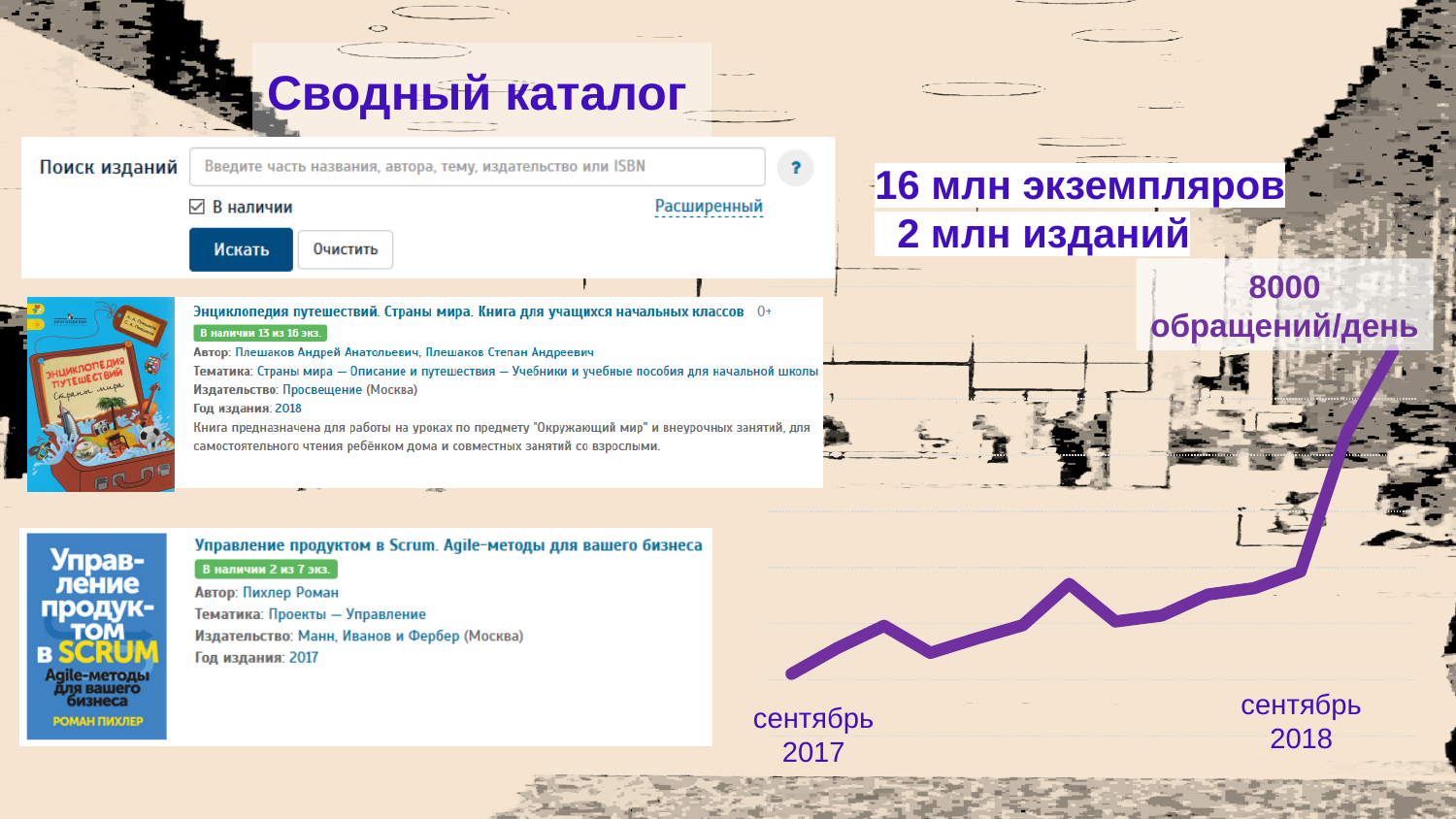
At which labelled point on the x axis is the line chart at its lowest? сентябрь 2017 What kind of chart is shown at the bottom right of the slide? line chart What is the first label on the x axis of the line chart? сентябрь 2017 Which of the two labelled points on the line chart has the higher value, сентябрь 2017 or сентябрь 2018? сентябрь 2018 At which labelled point on the x axis does the line chart reach its highest value? сентябрь 2018 Do the values in the line chart rise or fall from сентябрь 2017 to сентябрь 2018? rise What colour is the line in the chart? purple